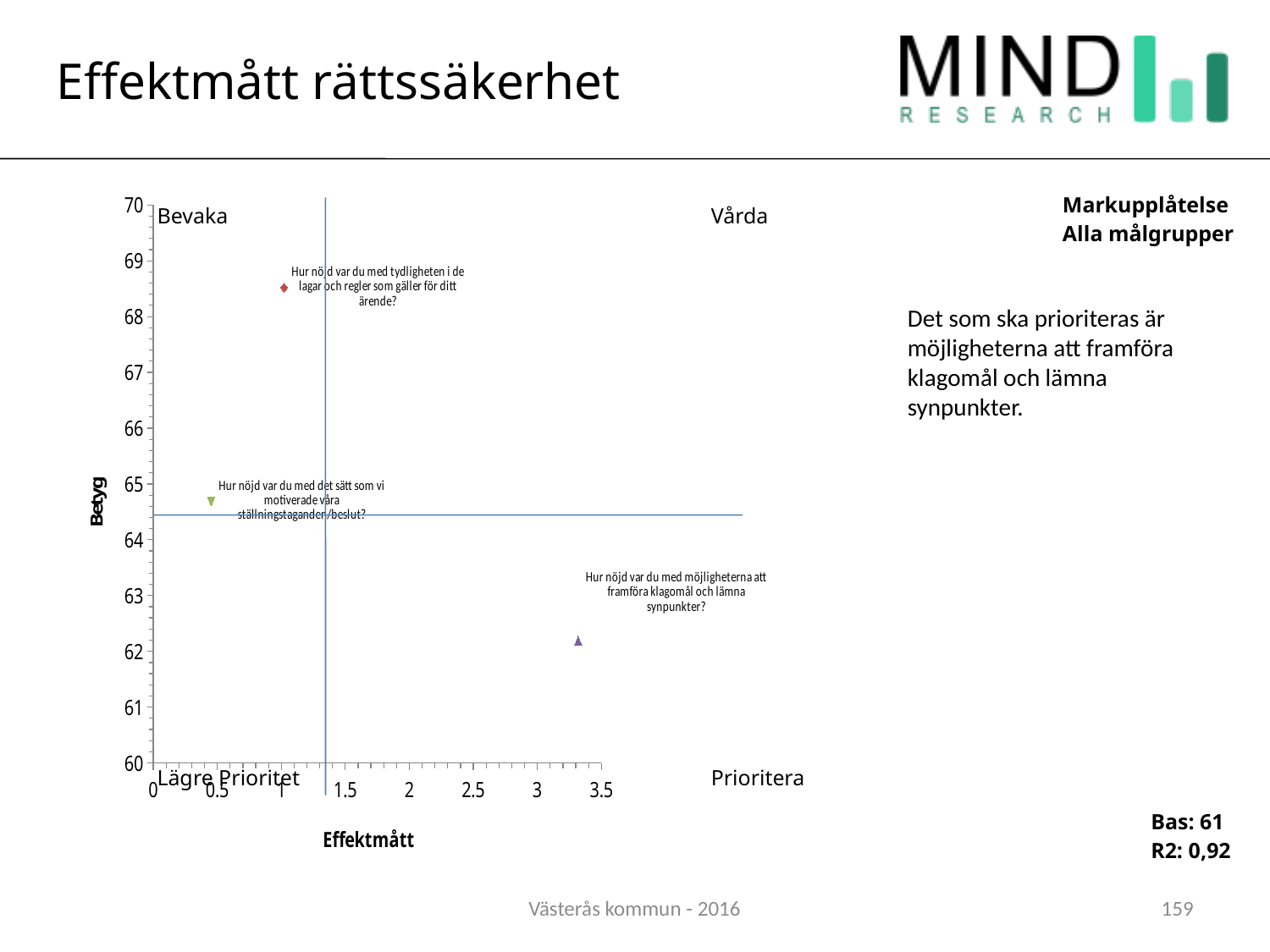
How many data points are plotted in the chart? 3 Which question has the highest Betyg value in the chart? Hur nöjd var du med tydligheten i de lagar och regler som gäller för ditt ärende? Which question has the lowest Betyg value in the chart? Hur nöjd var du med möjligheterna att framföra klagomål och lämna synpunkter? Which question has the lowest Effektmått value in the chart? Hur nöjd var du med det sätt som vi motiverade våra ställningstaganden/beslut? Which question has the highest Effektmått value in the chart? Hur nöjd var du med möjligheterna att framföra klagomål och lämna synpunkter? Is the Betyg value for 'Hur nöjd var du med tydligheten i de lagar och regler som gäller för ditt ärende?' greater or less than 68? greater What kind of chart is shown on the slide? scatter chart What is the title of the vertical axis of the chart? Betyg What label is shown in the lower-right quadrant of the chart? Prioritera Is the Effektmått value for 'Hur nöjd var du med möjligheterna att framföra klagomål och lämna synpunkter?' greater or less than 3? greater Which has a higher Betyg value: 'Hur nöjd var du med det sätt som vi motiverade våra ställningstaganden/beslut?' or 'Hur nöjd var du med möjligheterna att framföra klagomål och lämna synpunkter?' Hur nöjd var du med det sätt som vi motiverade våra ställningstaganden/beslut? Is the Betyg value for 'Hur nöjd var du med möjligheterna att framföra klagomål och lämna synpunkter?' greater or less than 63? less